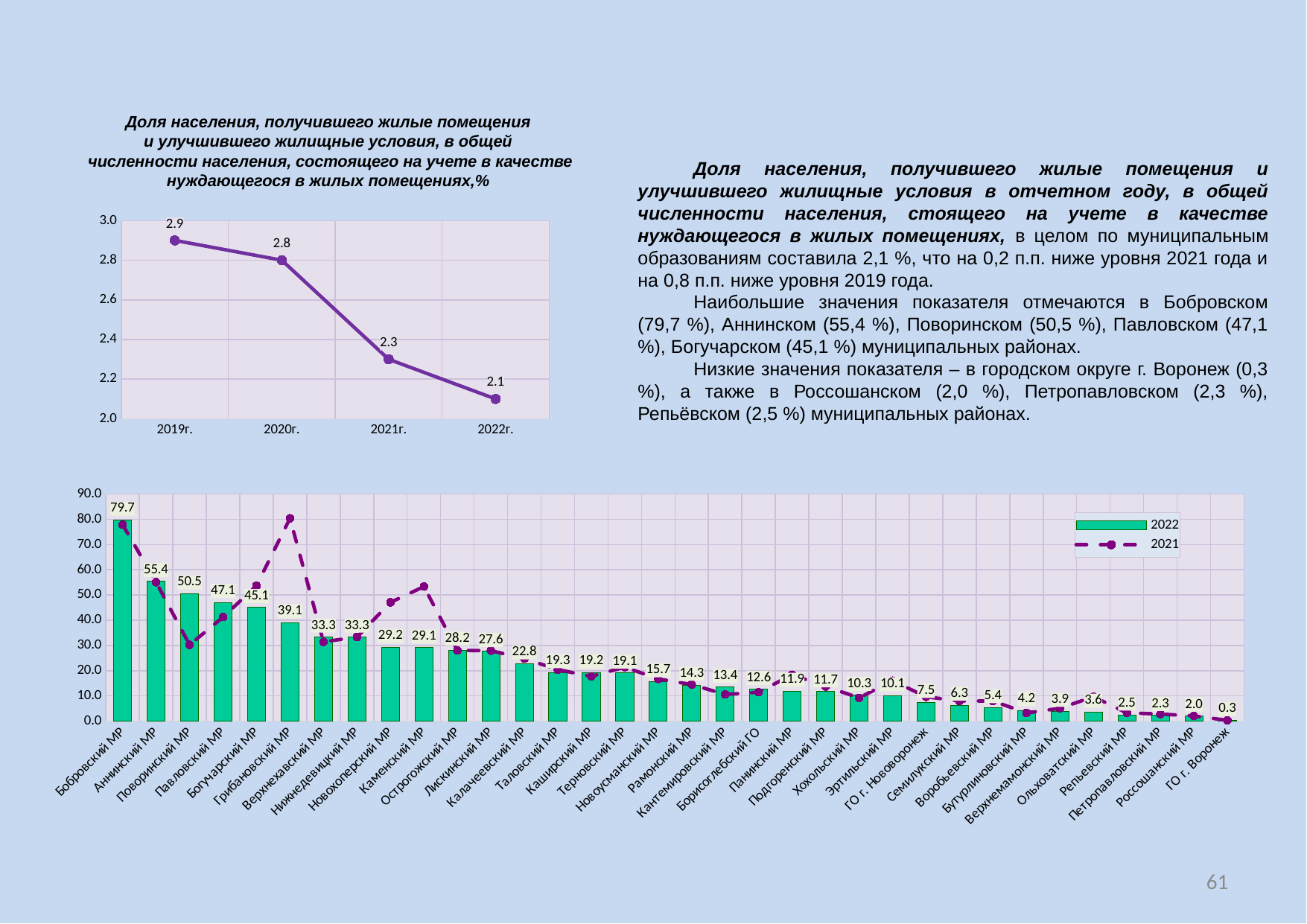
In the top-left line chart, what is the value for 2022г.? 2.1 In the top-left line chart, do the values rise or fall from 2019г. to 2022г.? fall In the bottom bar chart, what is the 2022 value for Лискинский МР? 27.6 In the bottom bar chart, what is the difference between the 2022 values for Аннинский МР and Поворинский МР? 4.9 In the bottom bar chart, which is larger for 2022: Павловский МР or Богучарский МР? Павловский МР How many series does the legend of the bottom chart list? 2 In the bottom bar chart, which category has the lowest 2022 value? ГО г. Воронеж In the bottom bar chart, is the 2021 value for Грибановский МР greater or less than 70.0? greater In the top-left line chart, what is the difference between the 2019г. and 2022г. values? 0.8 How many data points are plotted in the top-left line chart? 4 In the bottom bar chart, what is the 2022 value for Бобровский МР? 79.7 In the top-left line chart, what is the value for 2019г.? 2.9